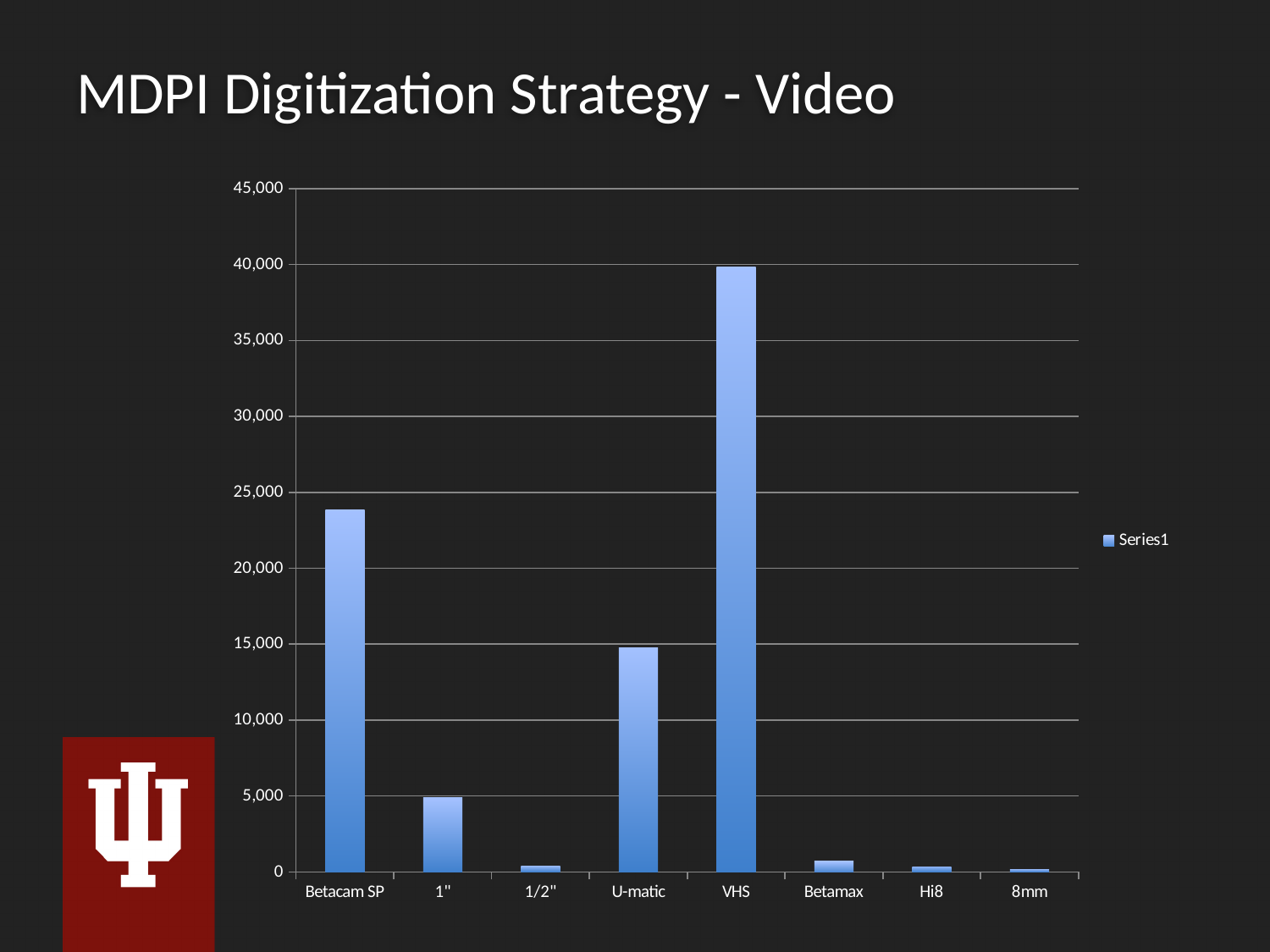
How many categories are shown on the x axis of the chart? 8 Is the value for VHS greater or less than 35,000? greater What kind of chart is shown on the slide? bar chart Which is larger, the value for Betacam SP or the value for U-matic? Betacam SP Which is larger, the value for VHS or the value for Betacam SP? VHS Is the value for Betamax greater or less than 5,000? less Which category has the highest value in the chart? VHS Is the value for U-matic greater or less than 10,000? greater What is the name of the series listed in the chart's legend? Series1 How many series does the chart's legend list? 1